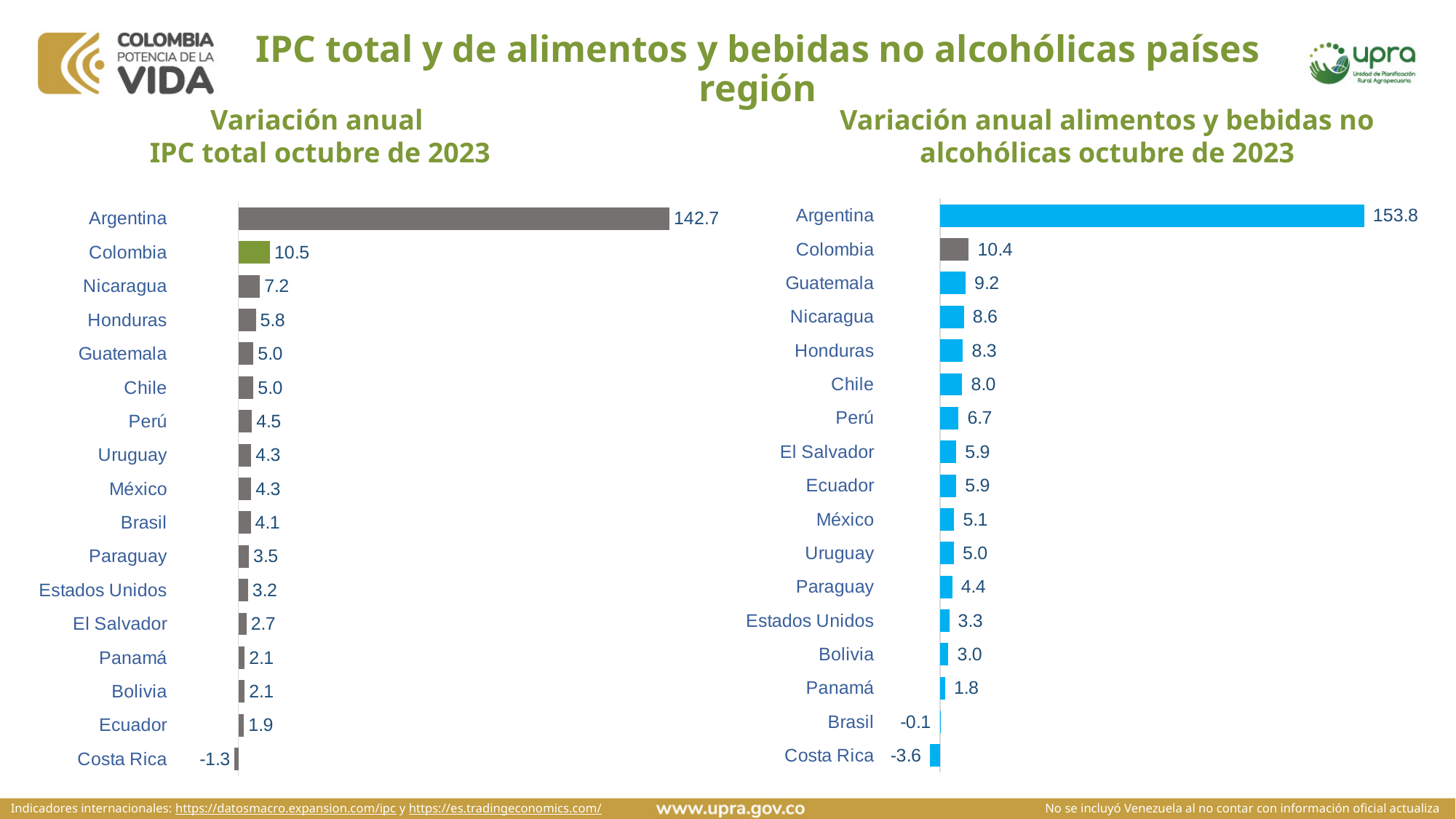
In the 'Variación anual IPC total octubre de 2023' chart, which bar is coloured green? Colombia In the 'Variación anual alimentos y bebidas no alcohólicas octubre de 2023' chart, which country has the lowest value? Costa Rica In the 'Variación anual IPC total octubre de 2023' chart, what is the difference between the values for Argentina and Colombia? 132.2 In the 'Variación anual alimentos y bebidas no alcohólicas octubre de 2023' chart, which is larger, the value for Nicaragua or the value for Chile? Nicaragua What kind of chart is the 'Variación anual alimentos y bebidas no alcohólicas octubre de 2023' chart? Bar chart How many countries are shown in the 'Variación anual IPC total octubre de 2023' chart? 17 In the 'Variación anual alimentos y bebidas no alcohólicas octubre de 2023' chart, what is the difference between the values for Colombia and Guatemala? 1.2 In the 'Variación anual alimentos y bebidas no alcohólicas octubre de 2023' chart, what is the value for Guatemala? 9.2 In the 'Variación anual IPC total octubre de 2023' chart, which country has the highest value? Argentina In the 'Variación anual IPC total octubre de 2023' chart, what is the value for Costa Rica? -1.3 In the 'Variación anual IPC total octubre de 2023' chart, what is the value for Colombia? 10.5 In the 'Variación anual alimentos y bebidas no alcohólicas octubre de 2023' chart, what is the value for Brasil? -0.1